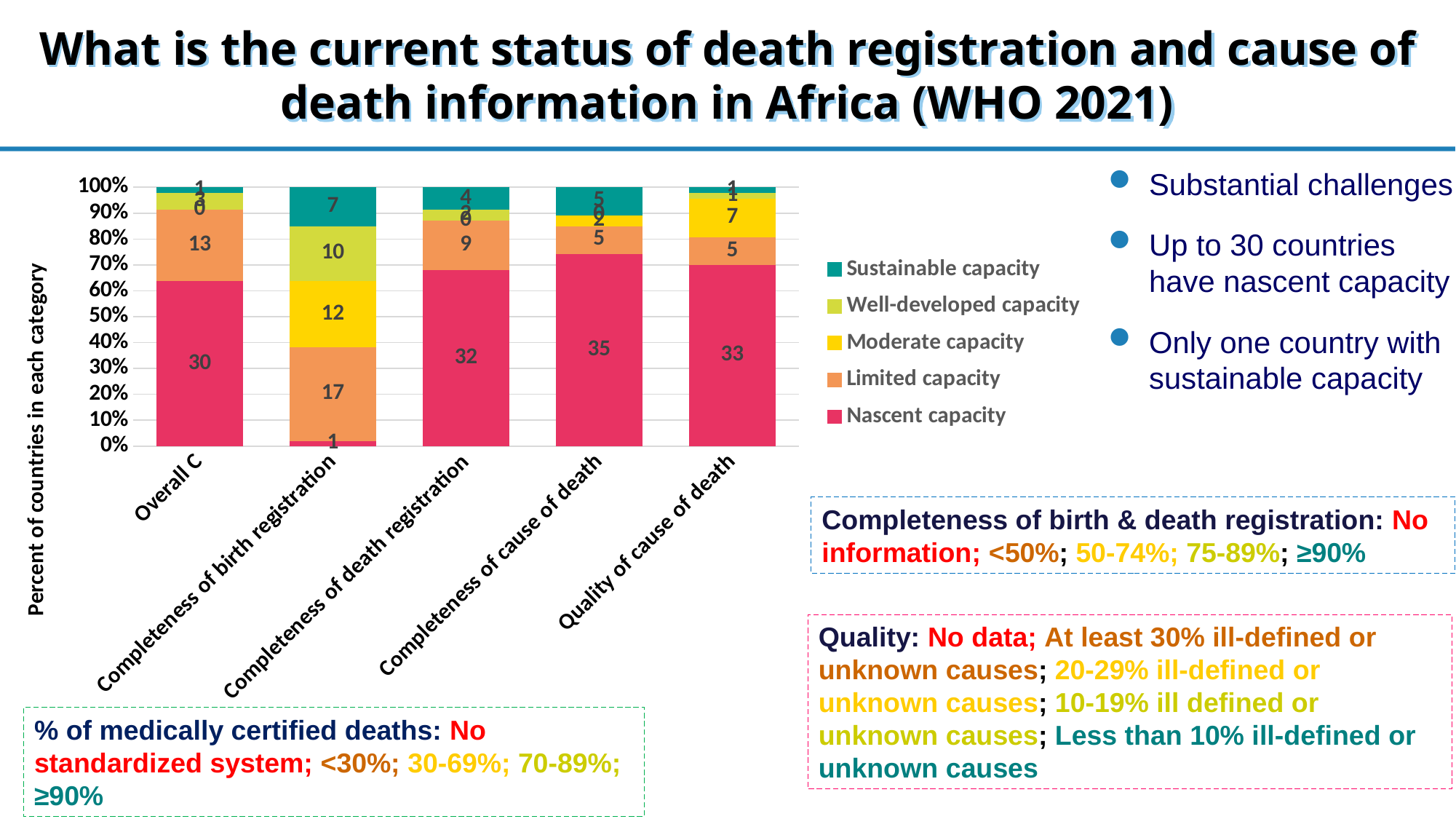
Which category has the highest Nascent capacity value? Completeness of cause of death How many categories are shown along the x axis of the chart? 5 How many series does the chart legend list? 5 Which category has the lowest Nascent capacity value? Completeness of birth registration What is the Moderate capacity value for Quality of cause of death? 7 What is the Limited capacity value for Completeness of birth registration? 17 What is the Nascent capacity value for Completeness of cause of death? 35 What is the Sustainable capacity value for Completeness of birth registration? 7 Which has the larger Limited capacity value, Overall C or Completeness of death registration? Overall C What is the difference between the Nascent capacity values for Completeness of cause of death and Completeness of death registration? 3 What kind of chart is shown on the slide? Stacked bar chart What is the total number of countries across all capacity levels for Completeness of birth registration? 47